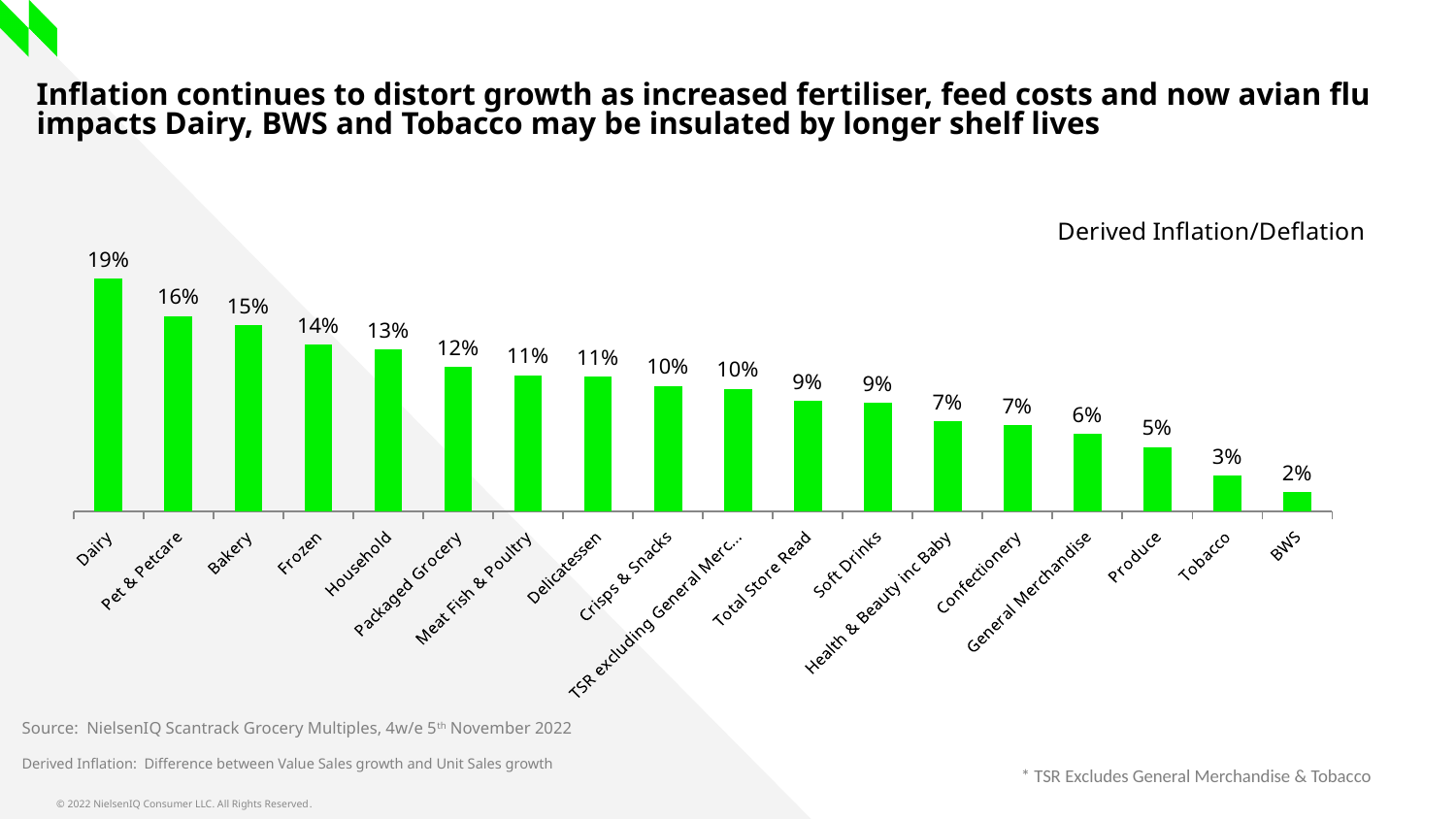
Do the values rise or fall moving from left to right along the x axis? Fall Which category has the highest derived inflation? Dairy Which has a higher derived inflation, Frozen or Confectionery? Frozen What is the derived inflation value for Soft Drinks? 9% How many categories are shown in the chart? 18 What is the derived inflation value for Dairy? 19% Which category has the lowest derived inflation? BWS What is the derived inflation value for Produce? 5% What type of chart is shown on the slide? Bar chart What is the difference between the derived inflation for Dairy and for BWS? 17% What is the derived inflation value for Household? 13% What is the difference between the derived inflation for Bakery and for Tobacco? 12%